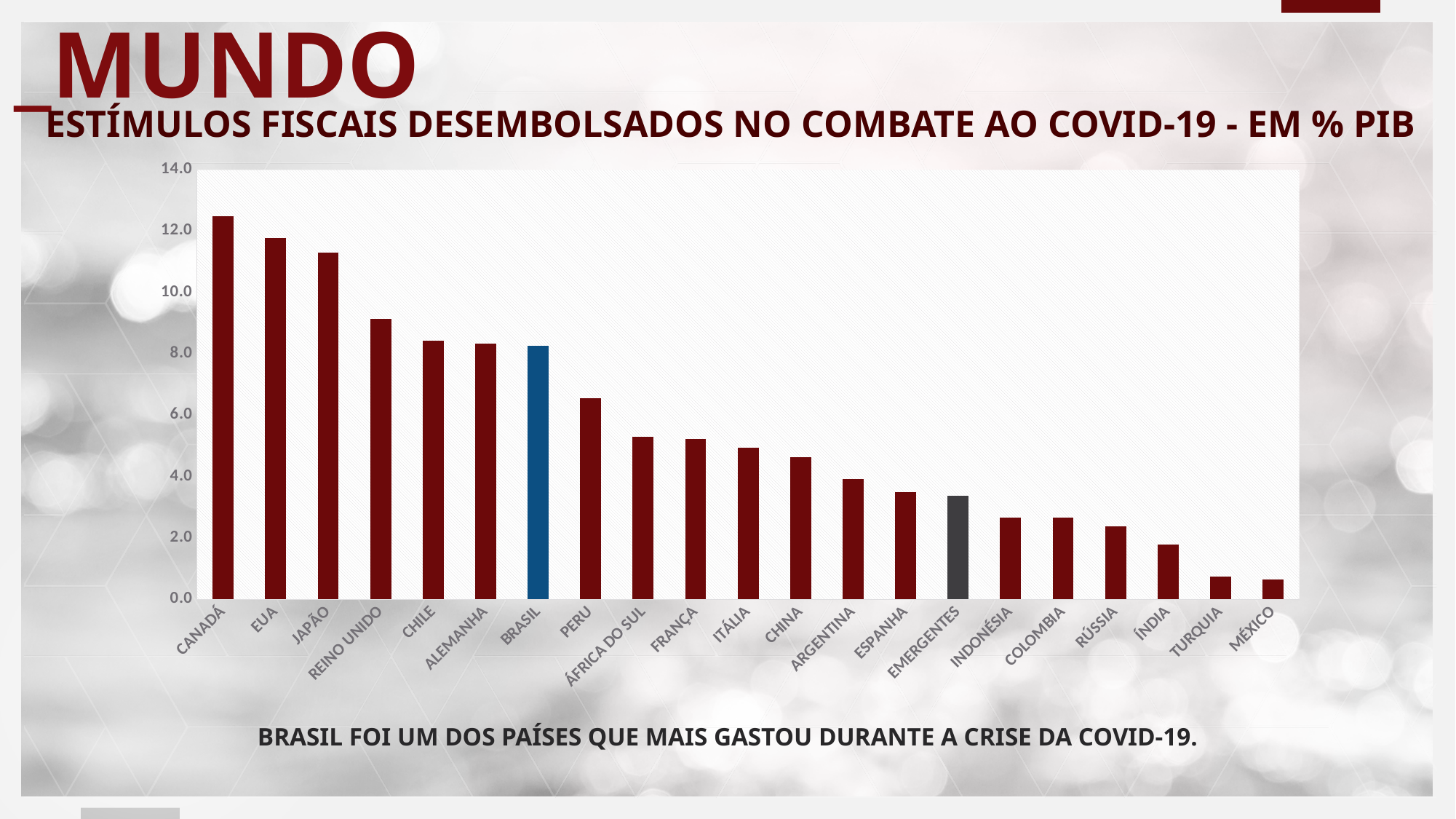
Is the value for Peru greater or less than 6? greater How many countries/categories are plotted on the chart? 21 Is the value for Índia greater or less than 2? less Which category's bar is coloured blue instead of dark red? Brasil What kind of chart is shown on the slide? bar chart Is the value for Reino Unido greater or less than 10? less Do the values rise or fall from left to right along the x axis? fall Which category has the highest value on the chart? Canadá Which has a larger value, EUA or Japão? EUA Which has a larger value, Peru or França? Peru